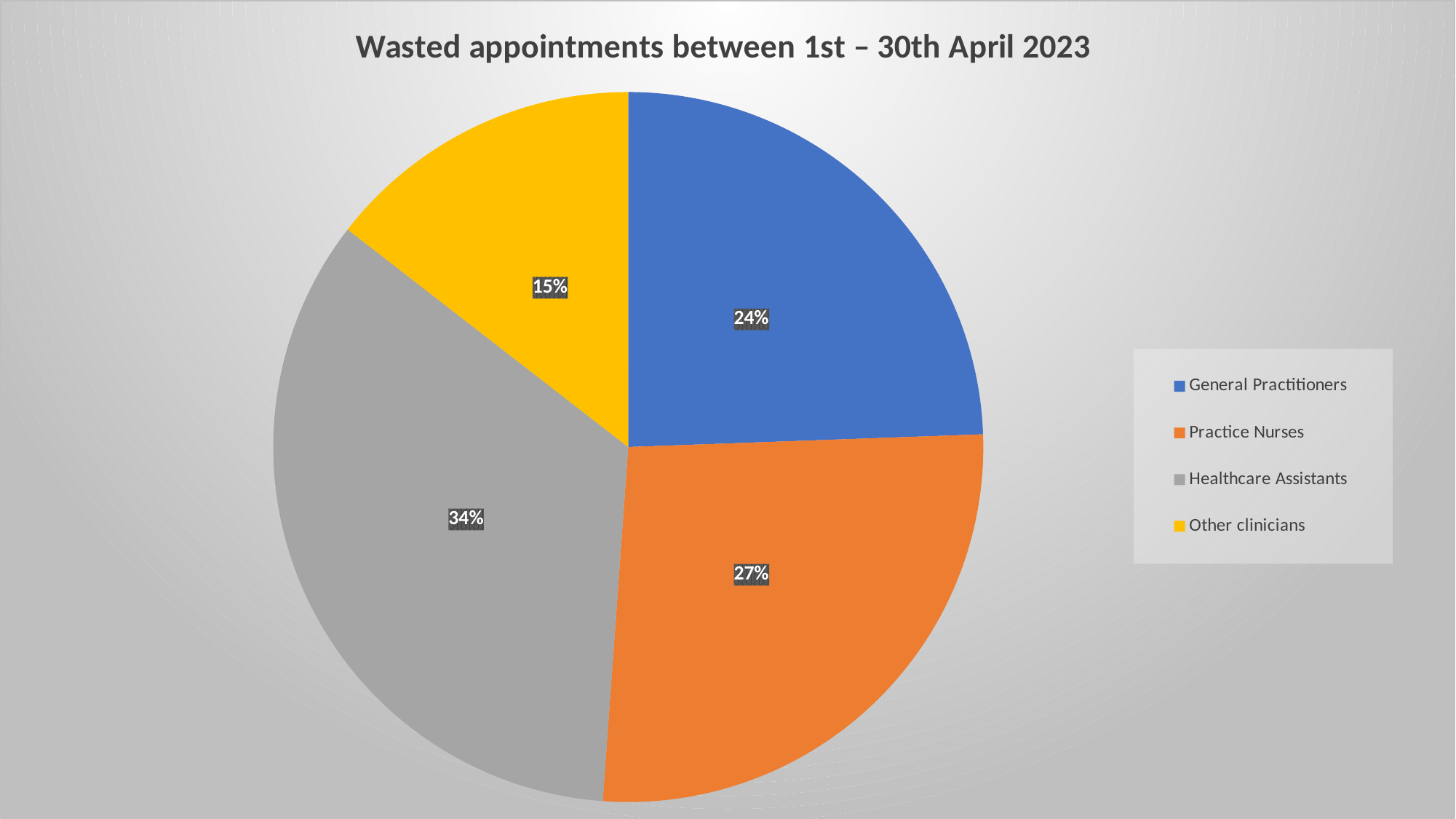
What share of wasted appointments is attributed to Healthcare Assistants? 34% Which category has the largest share of wasted appointments? Healthcare Assistants What is the difference in percentage points between Healthcare Assistants and Other clinicians? 19 What share of wasted appointments is attributed to Practice Nurses? 27% Which category has the smallest share of wasted appointments? Other clinicians What kind of chart is shown on the slide? pie chart Which colour represents Healthcare Assistants in the chart? grey Which has a larger share of wasted appointments, General Practitioners or Practice Nurses? Practice Nurses What is the title of the chart? Wasted appointments between 1st – 30th April 2023 What share of wasted appointments is attributed to Other clinicians? 15% What share of wasted appointments is attributed to General Practitioners? 24% How many categories does the pie chart show? 4